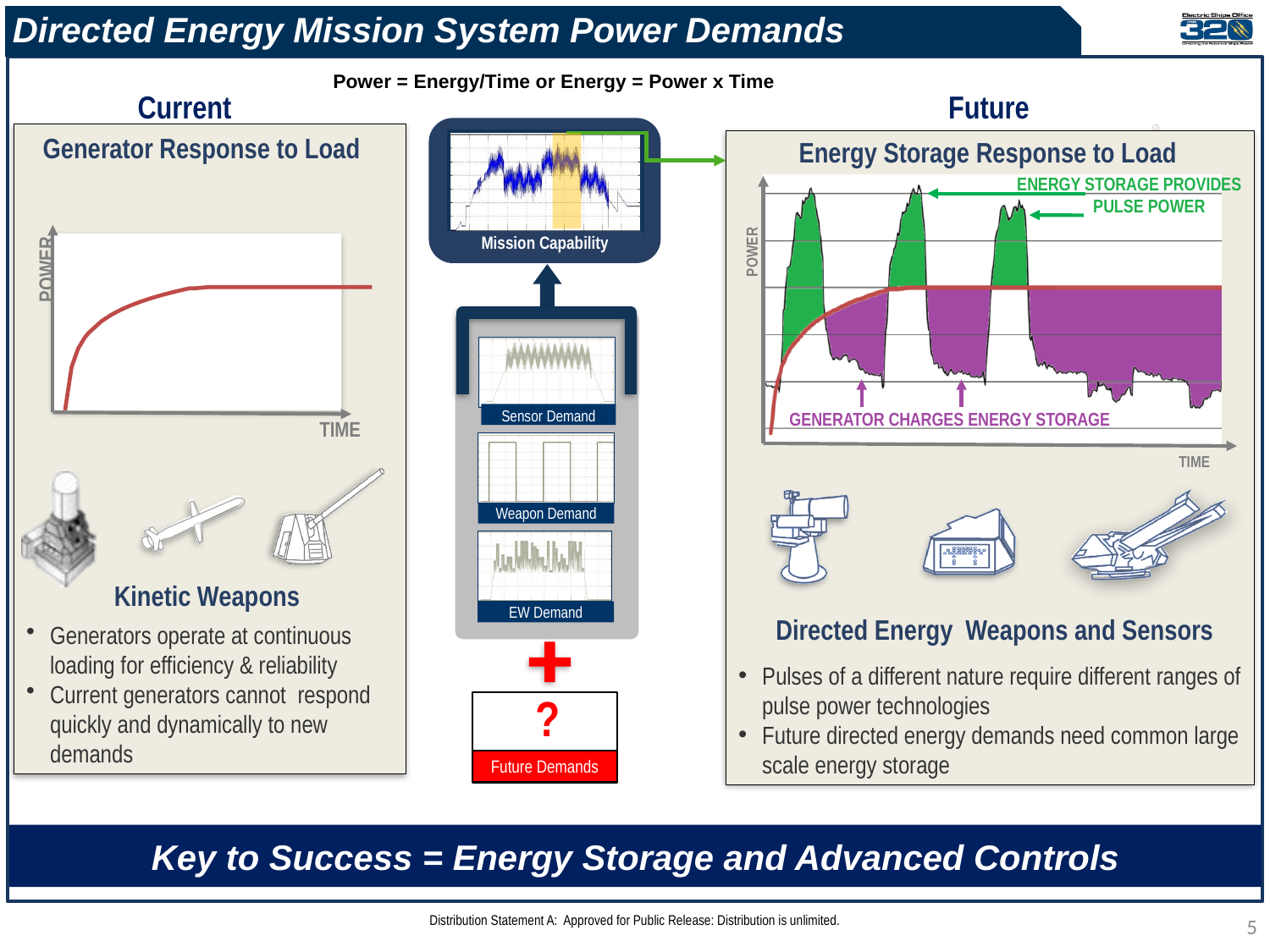
In the "Generator Response to Load" chart, does the power curve rise or fall as time increases? rises What kind of chart is the "Weapon Demand" thumbnail in the centre of the slide? line chart In the "Energy Storage Response to Load" chart, what colour are the regions labelled "GENERATOR CHARGES ENERGY STORAGE"? purple In the "Generator Response to Load" chart, does the red curve level off or keep rising steeply at the right end of the time axis? levels off How many demand thumbnail charts (Sensor, Weapon, EW) are stacked in the centre column of the slide? 3 What is the title of the chart on the right side of the slide under "Future"? Energy Storage Response to Load In the "Energy Storage Response to Load" chart, how many green pulse-power peaks are shown? 3 What kind of chart is the "Generator Response to Load" chart on the left of the slide? line chart